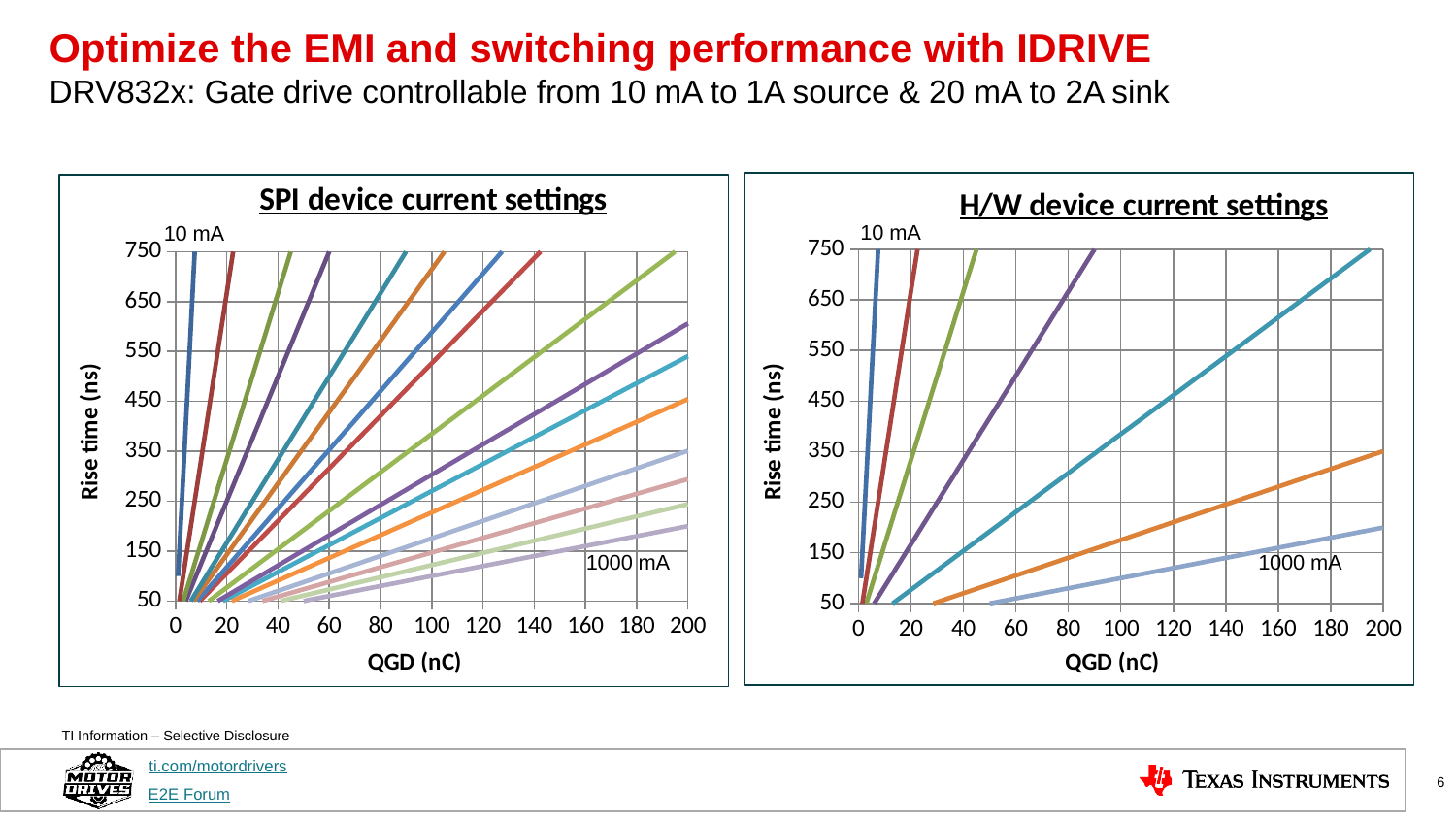
What is the y-axis label on the "H/W device current settings" chart? Rise time (ns) In the "SPI device current settings" chart, which labelled current setting reaches 750 ns at the smallest QGD, 10 mA or 1000 mA? 10 mA What is the highest value shown on the x axis of the "H/W device current settings" chart? 200 In the "H/W device current settings" chart, is the rise time of the 1000 mA line at 200 nC greater or less than 150? greater What kind of chart is the "SPI device current settings" chart? Line chart In the "H/W device current settings" chart, which line is steeper, the 10 mA line or the 1000 mA line? 10 mA In the "SPI device current settings" chart, is the rise time of the 1000 mA line at 200 nC greater or less than 250? less In the "H/W device current settings" chart, is the rise time of the 1000 mA line at 200 nC greater or less than 250? less In the "H/W device current settings" chart, how many lines are plotted? 7 What is the title of the chart on the right side of the slide? H/W device current settings In the "SPI device current settings" chart, does rise time rise or fall as QGD increases along the x axis? Rise What is the highest value shown on the y axis of the "SPI device current settings" chart? 750